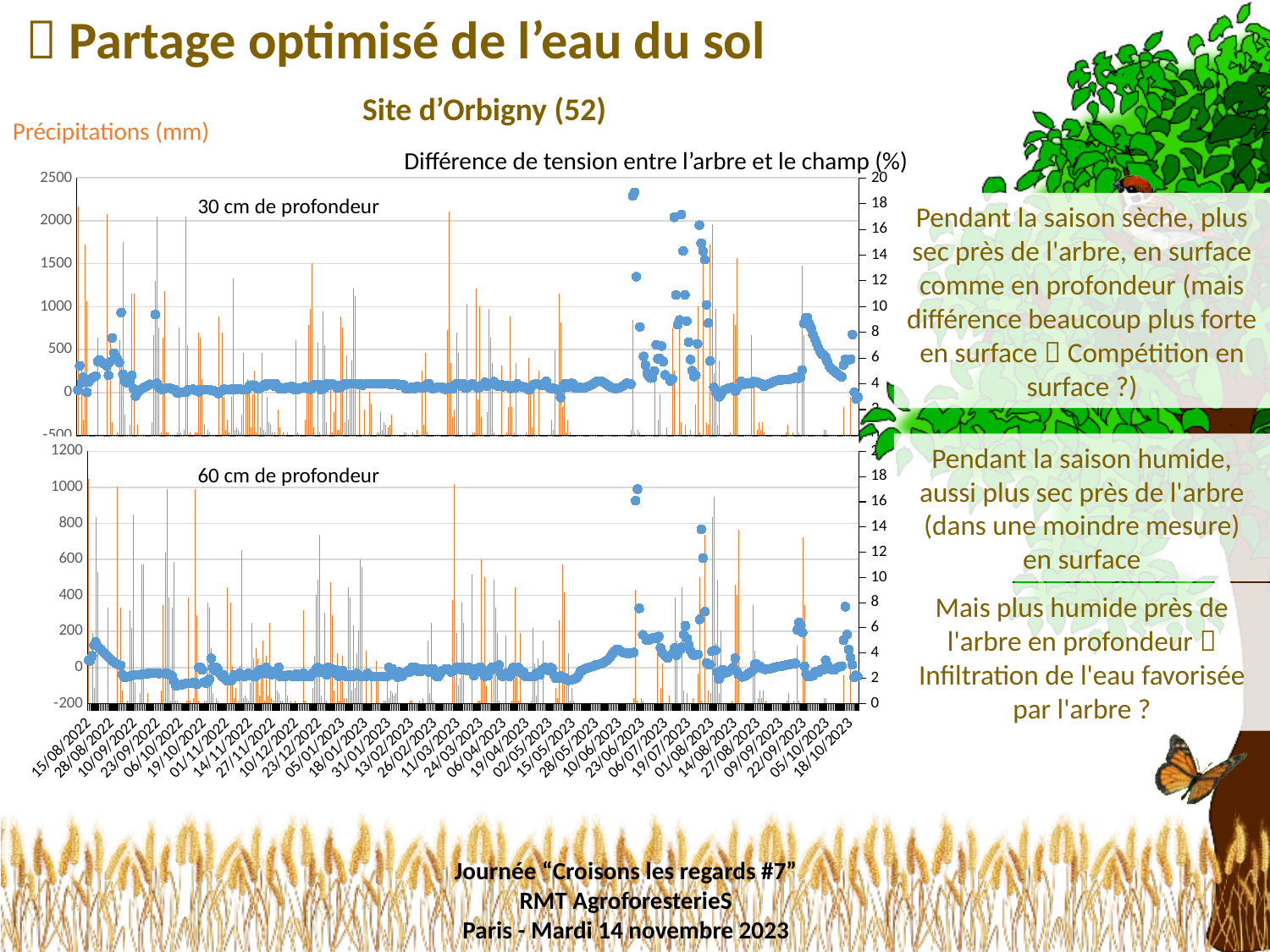
In the '30 cm de profondeur' chart, do the blue points rise or fall from 22/09/2023 to 18/10/2023? fall In the '60 cm de profondeur' chart, is the tallest orange bar greater or less than 800 on the left axis? greater In the '30 cm de profondeur' chart, is the highest blue point greater or less than 16 on the right axis? greater What is the title of the lower chart? 60 cm de profondeur In the '60 cm de profondeur' chart, is the highest blue point greater or less than 14 on the right axis? greater How many charts are shown on the slide? 2 Which chart has the higher maximum value on its left axis, '30 cm de profondeur' or '60 cm de profondeur'? 30 cm de profondeur What kind of chart is the '30 cm de profondeur' chart? A bar chart with overlaid scatter points